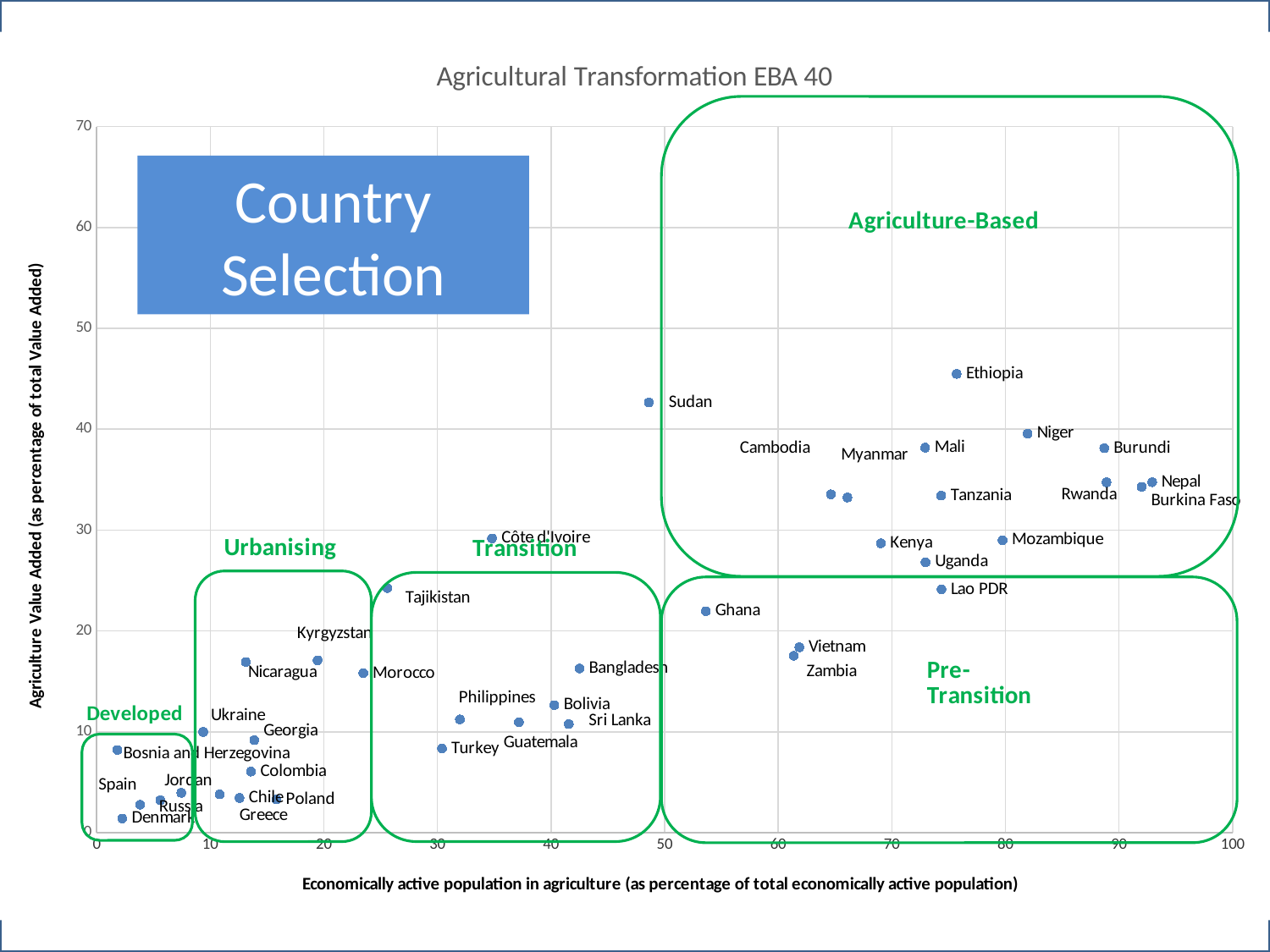
Which country has the highest Agriculture Value Added (y-axis) value? Ethiopia Is the Agriculture Value Added value for Morocco greater or less than 20? less Which has a higher Agriculture Value Added value, Ghana or Morocco? Ghana What is the title of the chart? Agricultural Transformation EBA 40 Is the Agriculture Value Added value for Ethiopia greater or less than 40? greater What is the label of the x axis? Economically active population in agriculture (as percentage of total economically active population) Which has a higher Agriculture Value Added value, Burundi or Tanzania? Burundi Is the Economically active population in agriculture value for Kenya greater or less than 60? greater What kind of chart is shown on the slide? scatter chart